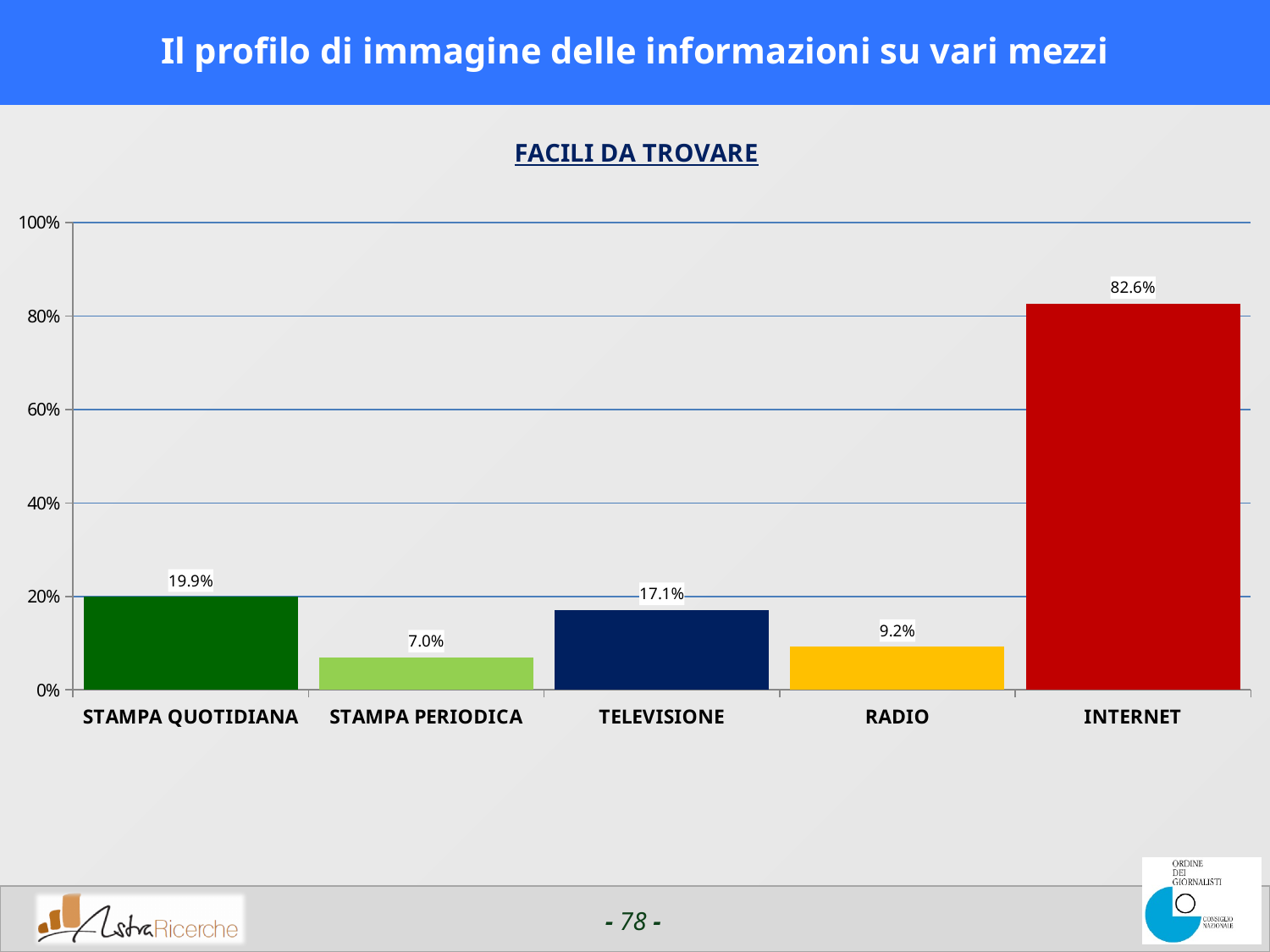
What is the value for RADIO? 9.2% Which is larger, the value for STAMPA QUOTIDIANA or the value for TELEVISIONE? STAMPA QUOTIDIANA What is the title shown above the chart? FACILI DA TROVARE Which category has the highest value? INTERNET What is the value for TELEVISIONE? 17.1% How many categories are shown on the x axis? 5 What is the value for STAMPA PERIODICA? 7.0% What kind of chart is shown on the slide? bar chart Which category has the lowest value? STAMPA PERIODICA Is the value for INTERNET greater or less than 80%? greater What is the difference between the values for INTERNET and STAMPA QUOTIDIANA? 62.7% What is the value for INTERNET? 82.6%